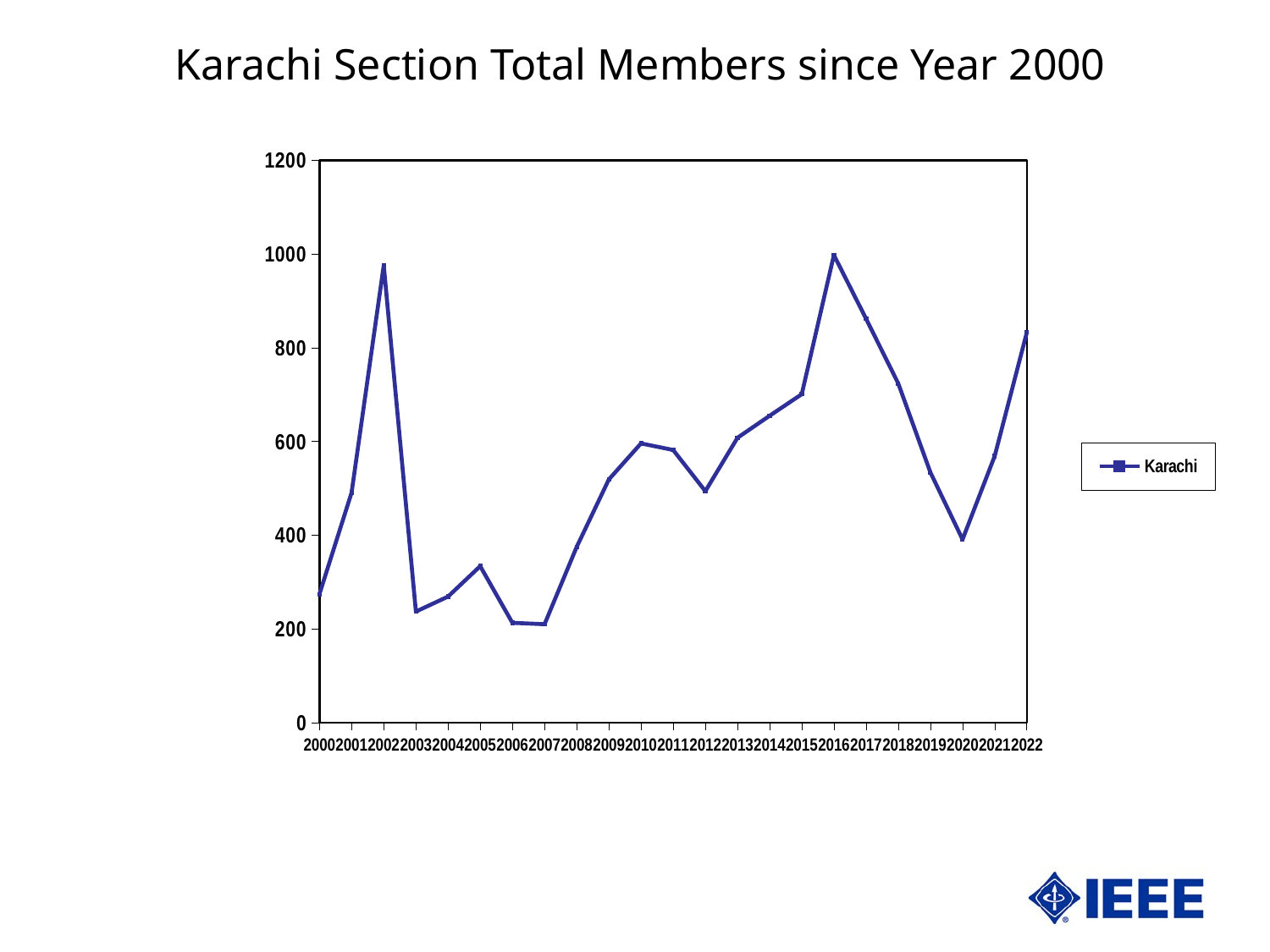
What is the title of the chart? Karachi Section Total Members since Year 2000 Which year has the larger value, 2002 or 2003? 2002 What kind of chart is shown on the slide? line chart Is the value for 2002 greater or less than 800? greater Is the value for 2022 greater or less than 800? greater Do the values rise or fall from 2016 to 2020? fall Is the value for 2020 greater or less than 600? less How many years are plotted along the x axis? 23 Which year has the larger value, 2017 or 2019? 2017 In which year is the Karachi membership highest? 2016 How many series does the legend list? 1